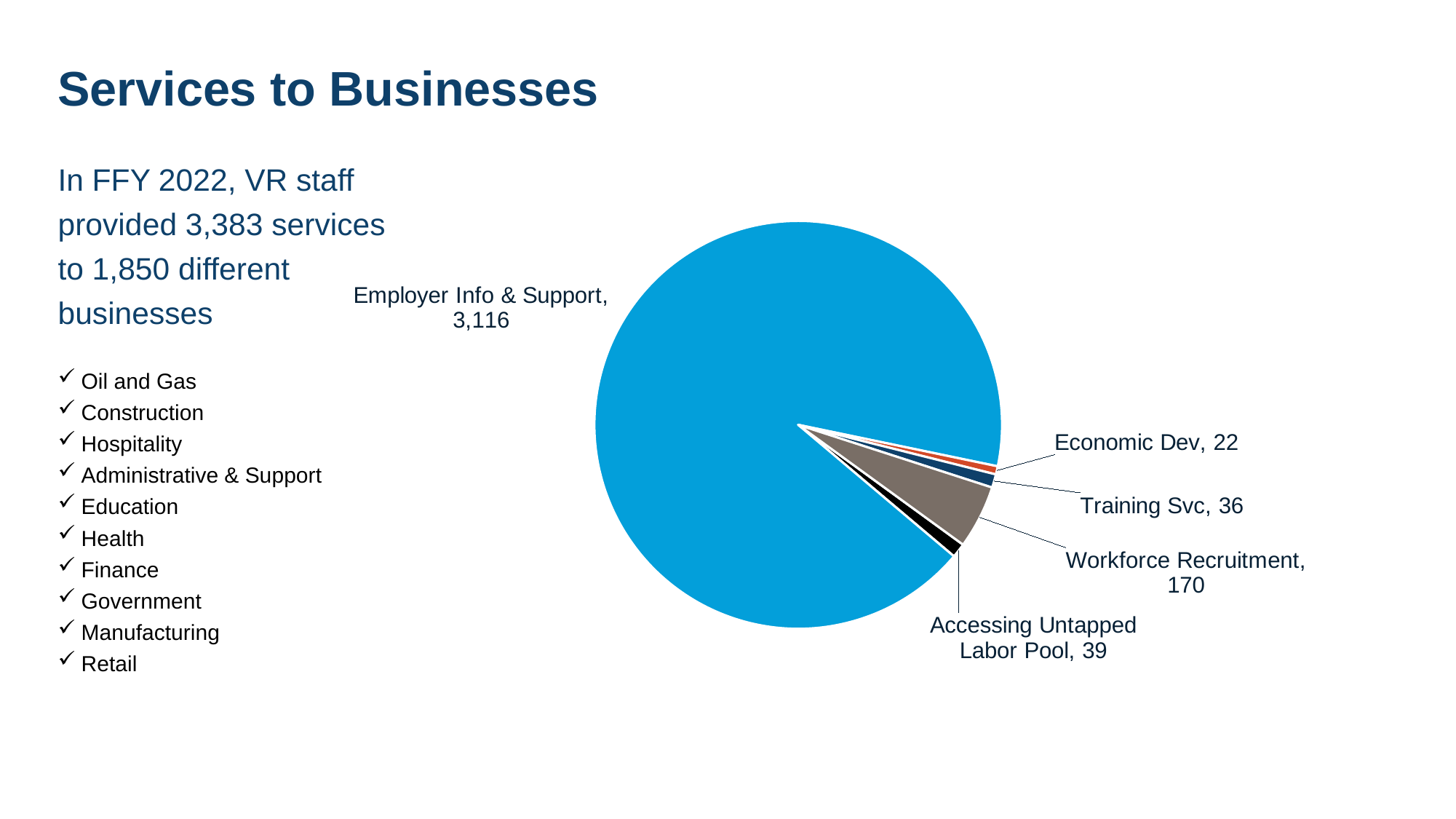
What is the difference between Training Svc and Economic Dev? 14 What is the total of all slices in the pie chart? 3,383 What is the difference between Workforce Recruitment and Accessing Untapped Labor Pool? 131 Which category has the smallest slice of the pie? Economic Dev Which category has the largest slice of the pie? Employer Info & Support Which is larger, Workforce Recruitment or Training Svc? Workforce Recruitment What is the value for Workforce Recruitment? 170 How many slices does the pie chart have? 5 What is the value for Employer Info & Support? 3,116 What type of chart is shown on the slide? Pie chart What is the value for Training Svc? 36 What is the value for Accessing Untapped Labor Pool? 39